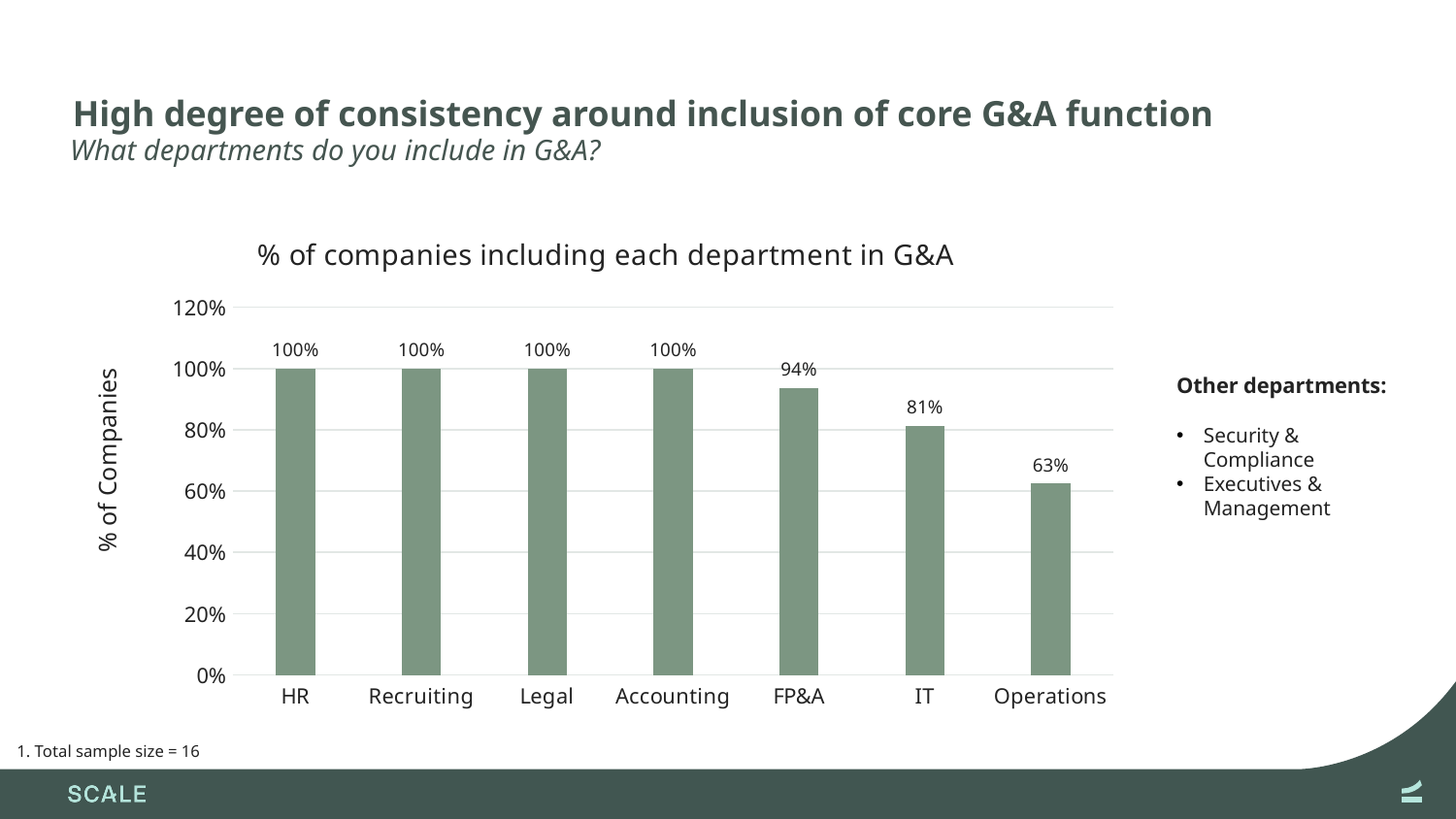
How many departments are shown on the x axis of the chart? 7 Which has a higher percentage, FP&A or IT? FP&A What percentage of companies include FP&A in G&A? 94% What percentage of companies include Operations in G&A? 63% Which department has the lowest percentage of companies including it in G&A? Operations What percentage of companies include IT in G&A? 81% What is the title of the chart? % of companies including each department in G&A What is the difference between the percentage for IT and the percentage for Operations? 18% What kind of chart is shown on the slide? Bar chart Is the value for Operations greater or less than 80%? less What is the difference between the percentage for HR and the percentage for FP&A? 6% What percentage of companies include Legal in G&A? 100%